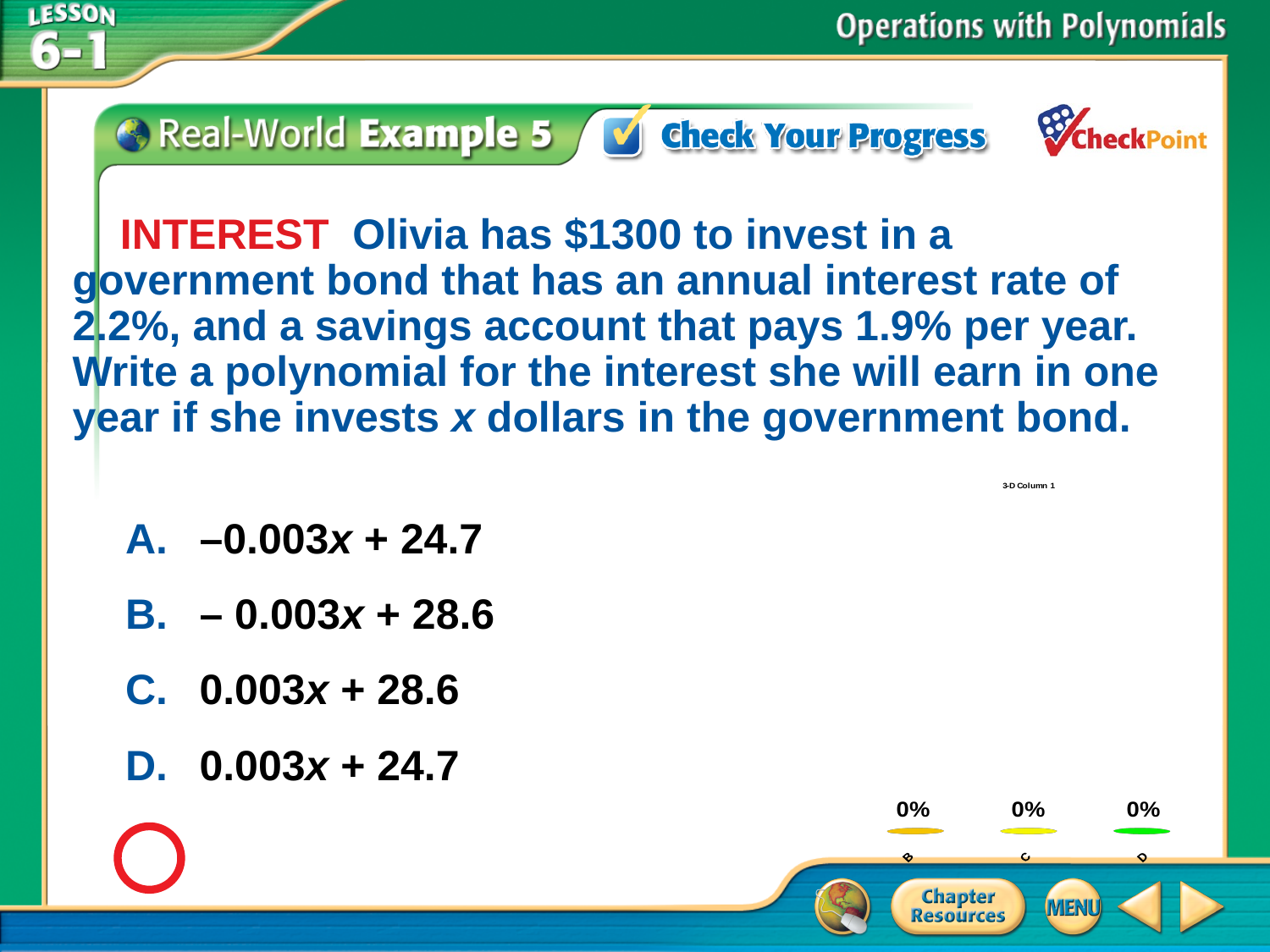
In the chart at the bottom right, what value is shown for category D? 0% In the chart at the bottom right, what value is shown for category C? 0% In the chart at the bottom right, what value is shown for category B? 0% In the chart at the bottom right, what colour is the bar for category D? green What kind of chart is shown at the bottom right of the slide? bar chart